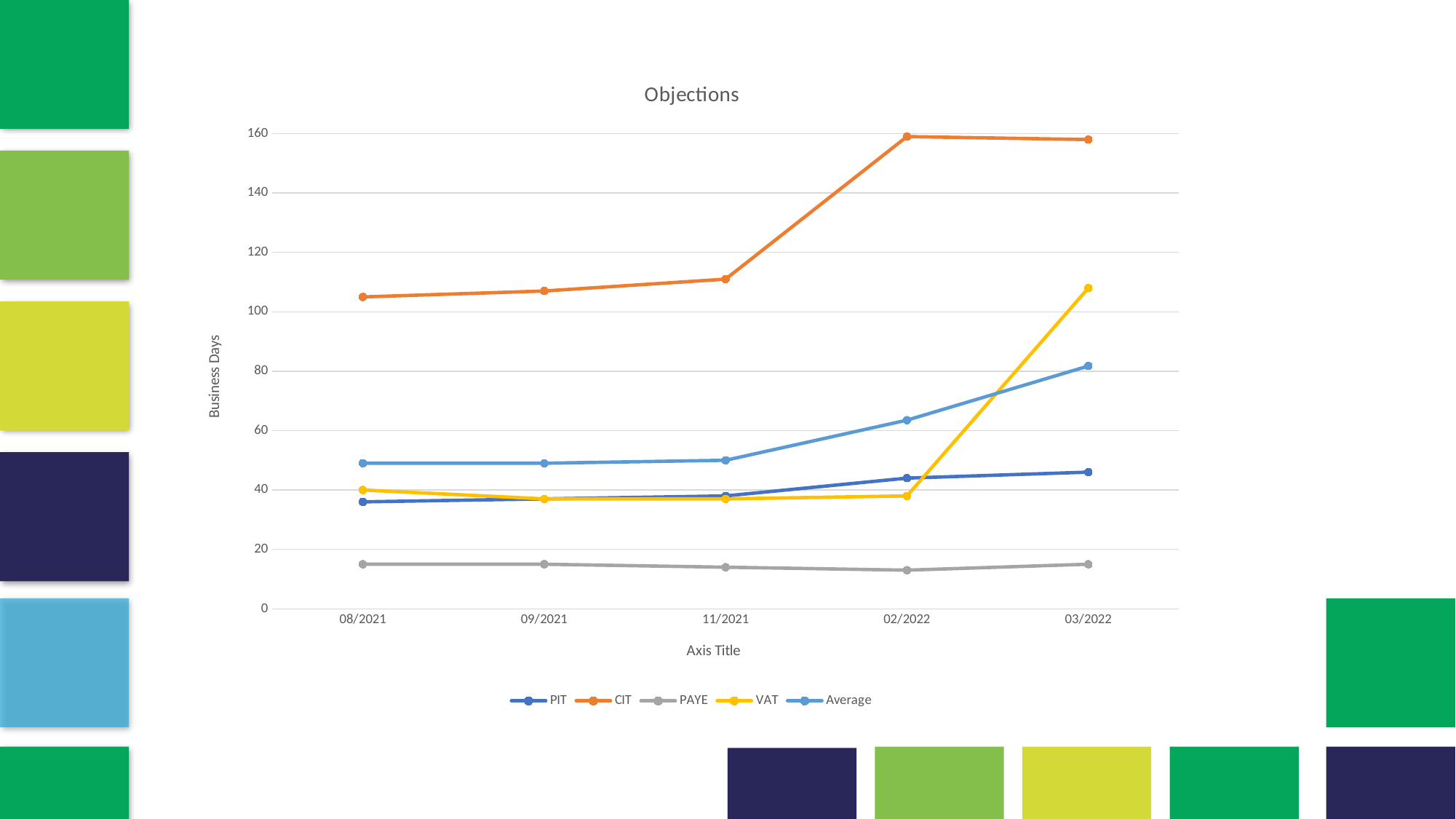
What is the title of the chart? Objections Is the value for PAYE at 08/2021 greater or less than 20? less How many time points are shown on the x axis? 5 Is the value for CIT at 02/2022 greater or less than 140? greater Which series has the lowest value at 02/2022? PAYE At 03/2022, which is larger: VAT or Average? VAT What kind of chart is shown on the slide? line chart What is the label on the vertical axis? Business Days Is the value for VAT at 03/2022 greater or less than 100? greater How many series does the legend list? 5 Which series has the highest value at 03/2022? CIT Does the CIT series rise or fall from 08/2021 to 02/2022? rise